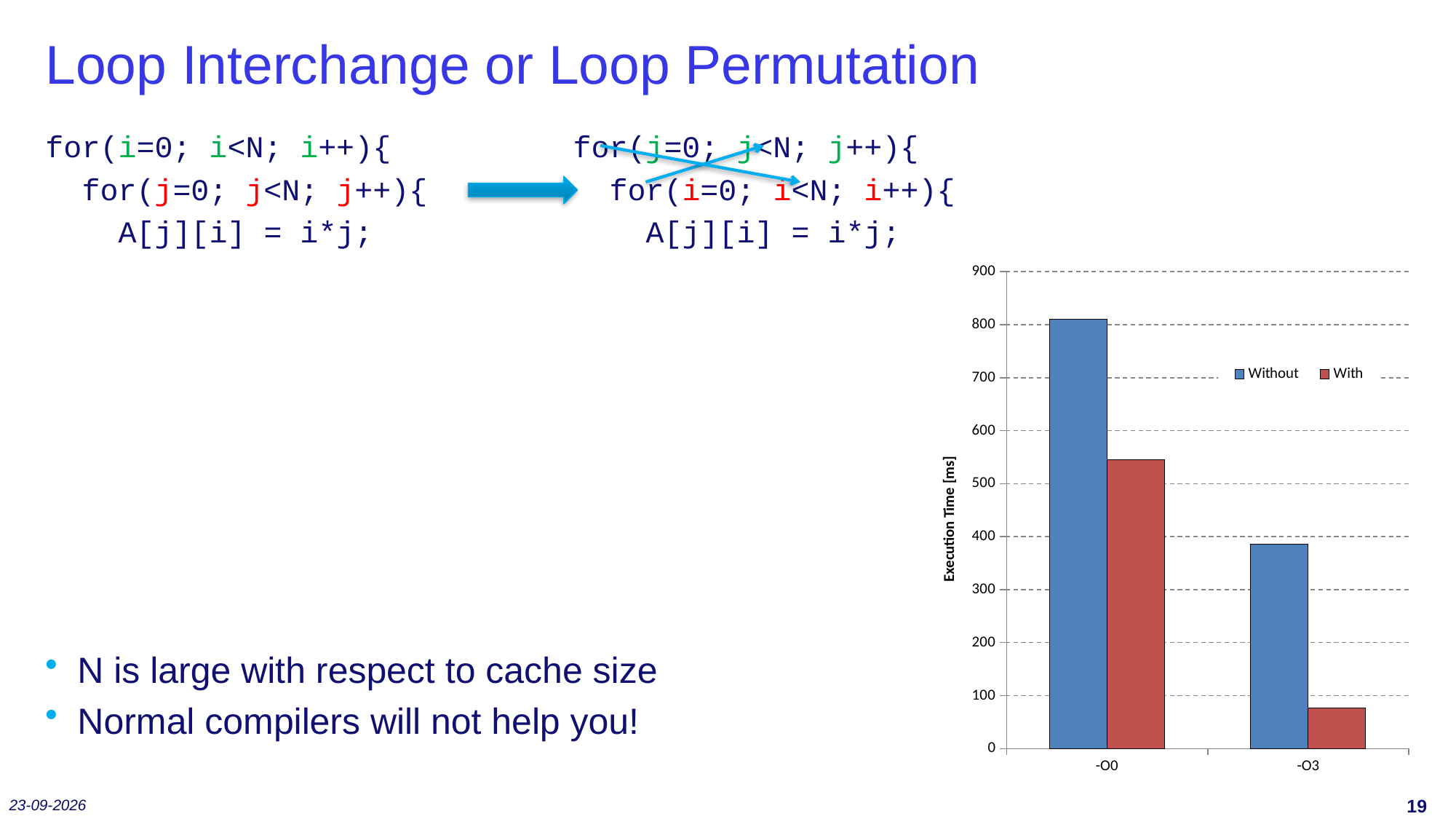
Which bar in the chart is the lowest overall? With at -O3 How many series does the chart's legend list? 2 For -O0, which is larger: the 'Without' bar or the 'With' bar? Without Which is larger: the 'With' bar for -O0 or the 'Without' bar for -O3? With for -O0 Which category has the highest 'Without' bar? -O0 Is the 'Without' value for -O0 greater or less than 800? greater How many categories are shown on the x axis of the chart? 2 Which colour represents the 'With' series in the chart? red What kind of chart is shown on the slide? bar chart Is the 'With' value for -O3 greater or less than 100? less What is the label of the chart's y axis? Execution Time [ms] Is the 'Without' value for -O3 greater or less than 400? less